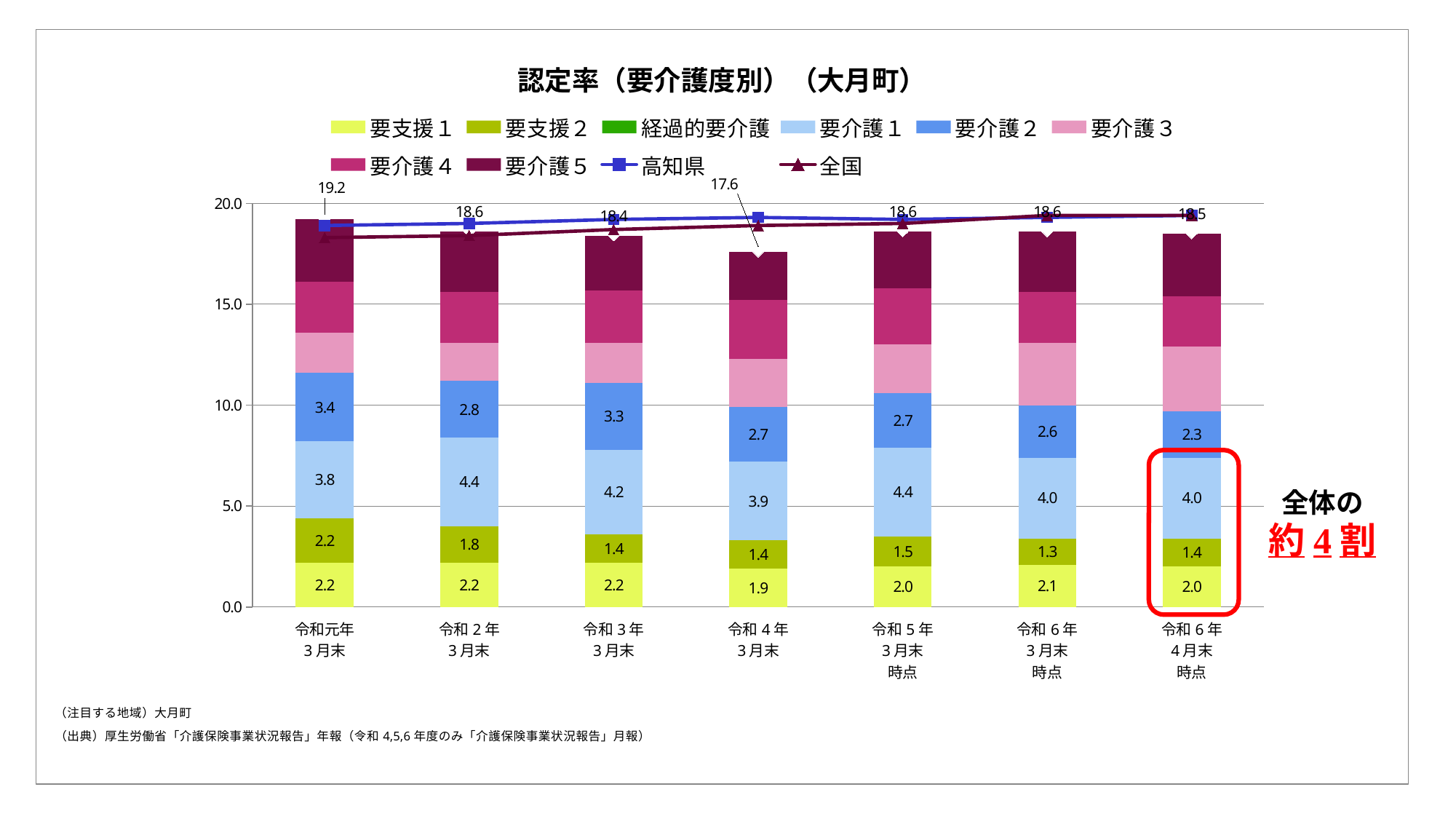
How many series does the legend list? 10 What is the value of 要介護１ for 令和４年３月末? 3.9 What is the total labelled above the stacked bar for 令和４年３月末? 17.6 What is the value of 要介護２ for 令和元年３月末? 3.4 Which is larger, the 要介護１ value for 令和２年３月末 or for 令和元年３月末? 令和２年３月末 What is the title of the chart? 認定率（要介護度別）（大月町） What is the value of 要支援２ for 令和６年４月末時点? 1.4 How many periods are shown on the x axis? 7 Which period has the lowest total labelled above its stacked bar? 令和４年３月末 What is the difference between the 要介護２ values for 令和元年３月末 and 令和６年４月末時点? 1.1 What kind of chart is this? Stacked bar chart with line series Which period has the highest total labelled above its stacked bar? 令和元年３月末